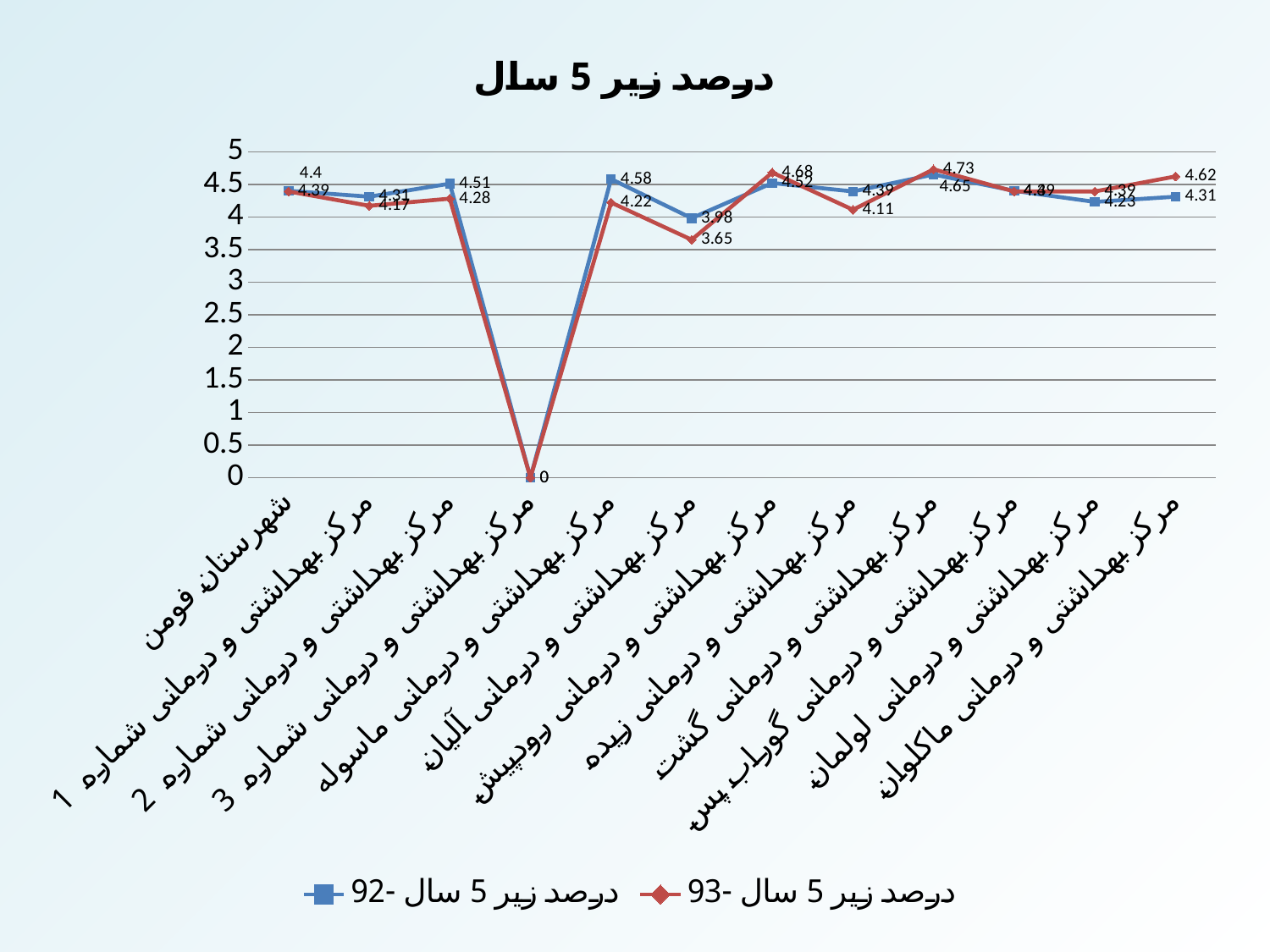
What is the difference between the 92 and 93 values for مرکز بهداشتی و درمانی ماکلوان? 0.31 How many series does the legend list? 2 Which category has the lowest value in the 'درصد زیر 5 سال -92' series? مرکز بهداشتی و درمانی شماره 3 What is the value of the 'درصد زیر 5 سال -93' series for مرکز بهداشتی و درمانی آلیان? 3.65 What is the value of the 'درصد زیر 5 سال -92' series for مرکز بهداشتی و درمانی ماسوله? 4.58 Which category has the highest value in the 'درصد زیر 5 سال -93' series? مرکز بهداشتی و درمانی گشت What is the title of the chart? درصد زیر 5 سال What kind of chart is shown on the slide? line chart How many categories are plotted along the x axis? 12 Is the 'درصد زیر 5 سال -93' value for مرکز بهداشتی و درمانی زیده greater or less than 4.5? less What is the value of the 'درصد زیر 5 سال -93' series for مرکز بهداشتی و درمانی گشت? 4.73 For مرکز بهداشتی و درمانی آلیان, which series has the larger value, 92 or 93? 92